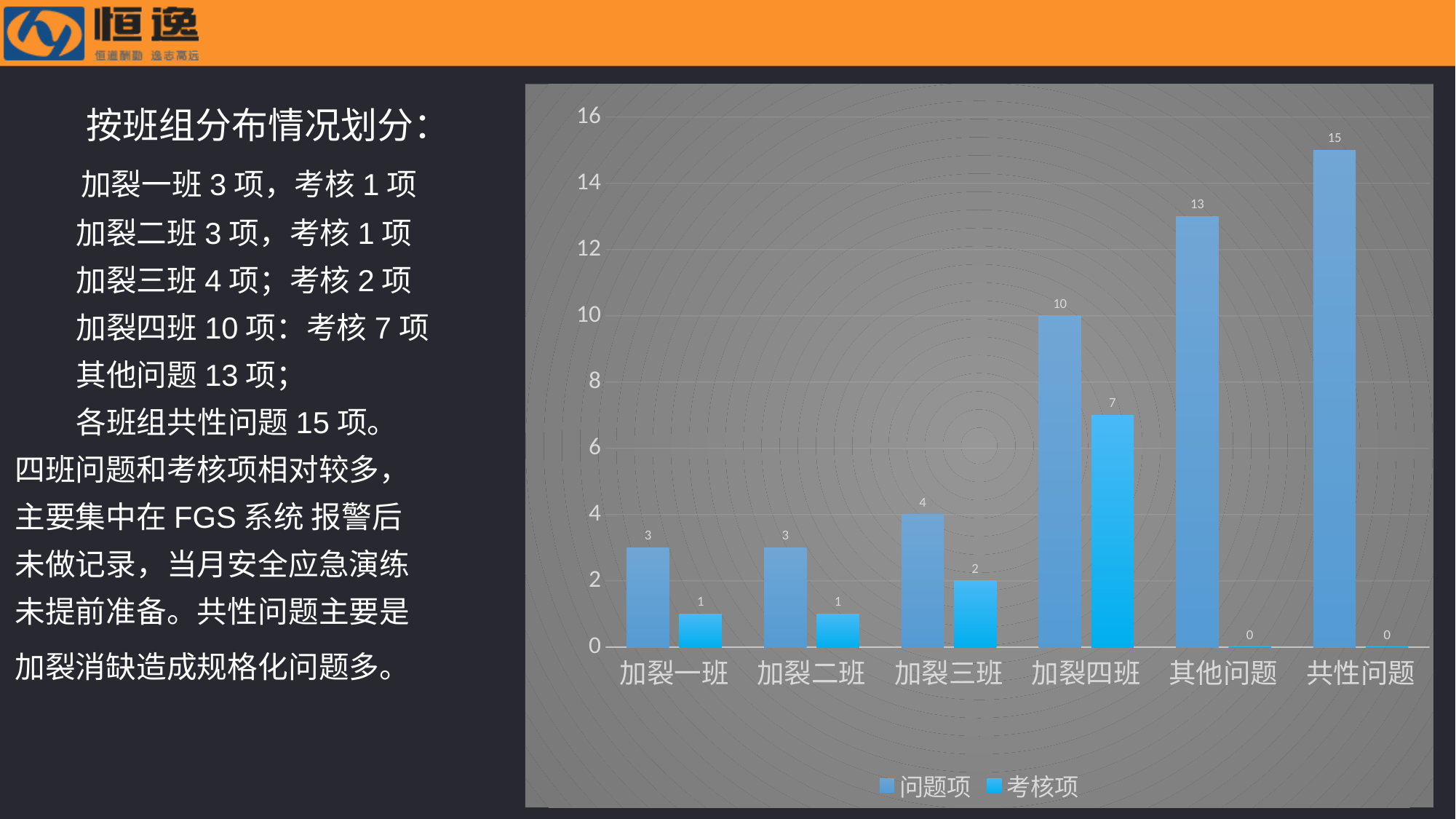
What is the 问题项 value for 其他问题? 13 How many categories are shown on the x axis? 6 What is the 考核项 value for 共性问题? 0 What is the 问题项 value for 加裂四班? 10 What kind of chart is shown on the slide? bar chart Which category has the highest 问题项 value? 共性问题 Which is larger, the 问题项 value for 加裂三班 or for 加裂四班? 加裂四班 How many series does the legend list? 2 What is the difference between the 问题项 values for 共性问题 and 其他问题? 2 What is the 考核项 value for 加裂三班? 2 Which category has the highest 考核项 value? 加裂四班 What is the difference between the 问题项 and 考核项 values for 加裂四班? 3